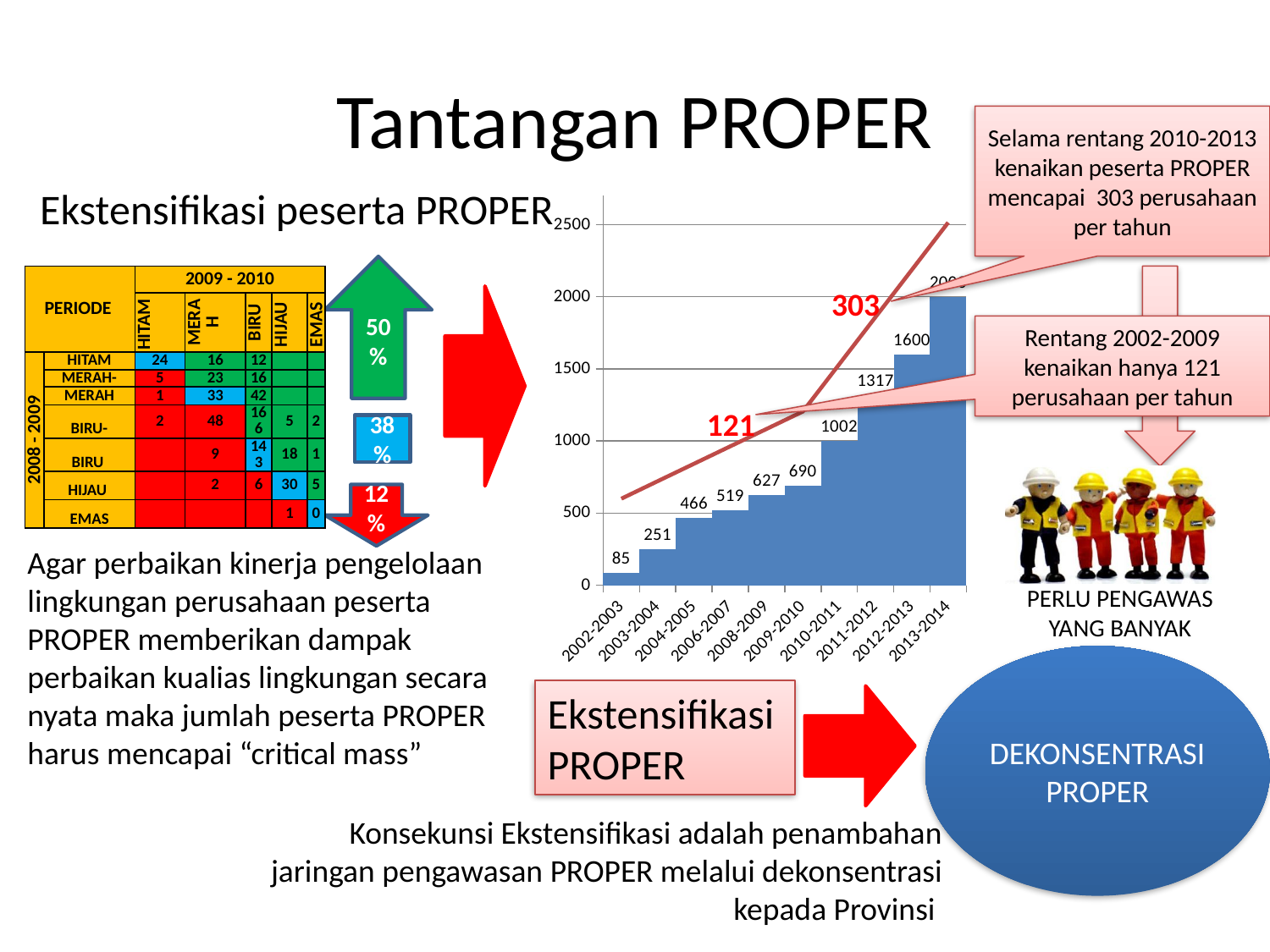
What is the value for 2012-2013 in the bar chart? 1600 Is the value for 2013-2014 in the bar chart greater or less than 1500? greater Which period has the lowest value in the bar chart? 2002-2003 What is the value for 2009-2010 in the bar chart? 690 What is the value for 2002-2003 in the bar chart? 85 Which period has the highest value in the bar chart? 2013-2014 What is the difference between the values for 2012-2013 and 2011-2012 in the bar chart? 283 What is the difference between the values for 2010-2011 and 2009-2010 in the bar chart? 312 Which is larger in the bar chart, the value for 2008-2009 or the value for 2006-2007? 2008-2009 How many periods are shown on the x axis of the bar chart? 10 Do the values in the bar chart rise or fall from 2002-2003 to 2013-2014? rise What is the value for 2011-2012 in the bar chart? 1317